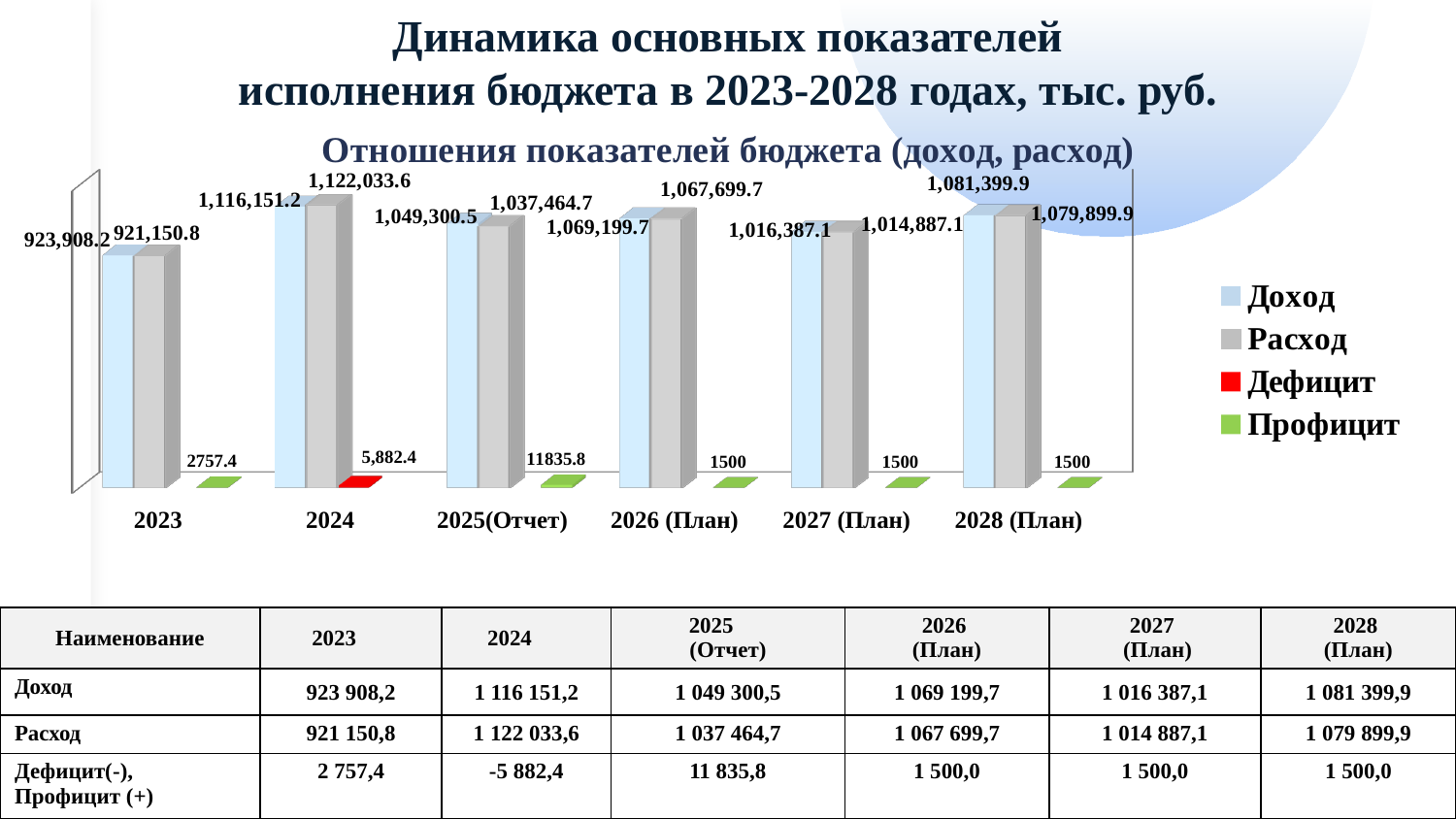
Which year has the lowest Расход value? 2023 What kind of chart is shown on the slide? Bar chart Does the Доход value rise or fall from 2023 to 2024? Rise What is the difference between Доход and Расход for 2023? 2,757.4 Which year has the highest Доход value? 2024 What is the value of Профицит for 2025(Отчет)? 11835.8 For 2024, which is larger: Доход or Расход? Расход What colour represents Дефицит in the legend? Red How many series does the legend list? 4 What is the value of Доход for 2023? 923,908.2 What is the value of Расход for 2028 (План)? 1,079,899.9 How many year categories are shown on the x axis? 6